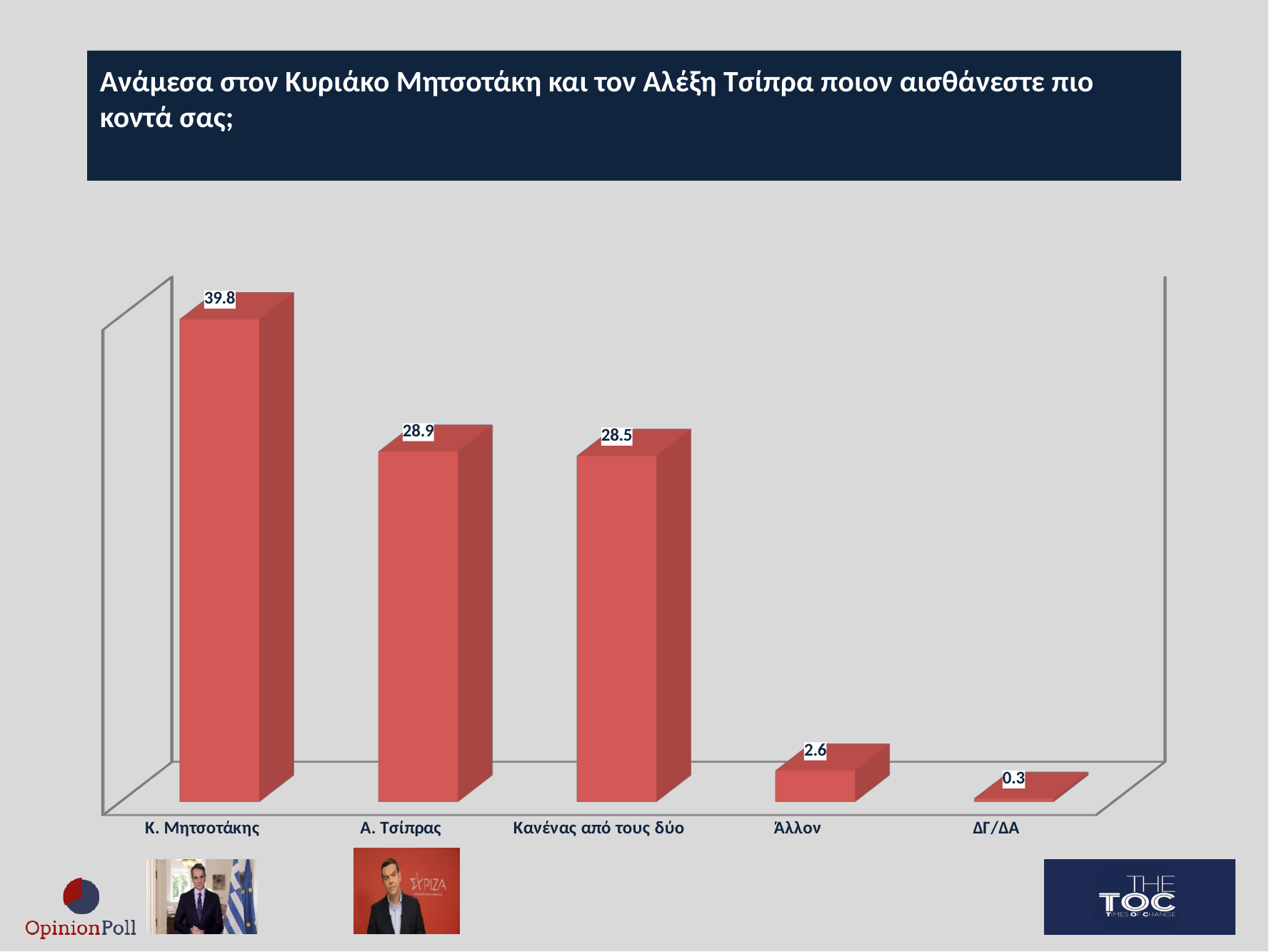
What is the value for Α. Τσίπρας? 28.9 What is the value for Κανένας από τους δύο? 28.5 Which is larger, the value for Κ. Μητσοτάκης or the value for Κανένας από τους δύο? Κ. Μητσοτάκης What is the value for ΔΓ/ΔΑ? 0.3 What is the value for Κ. Μητσοτάκης? 39.8 What is the difference between the values for Κ. Μητσοτάκης and Α. Τσίπρας? 10.9 What is the difference between the values for Άλλον and ΔΓ/ΔΑ? 2.3 How many categories are shown in the chart? 5 What is the value for Άλλον? 2.6 What kind of chart is shown on the slide? Bar chart Which category has the lowest value? ΔΓ/ΔΑ Which category has the highest value? Κ. Μητσοτάκης